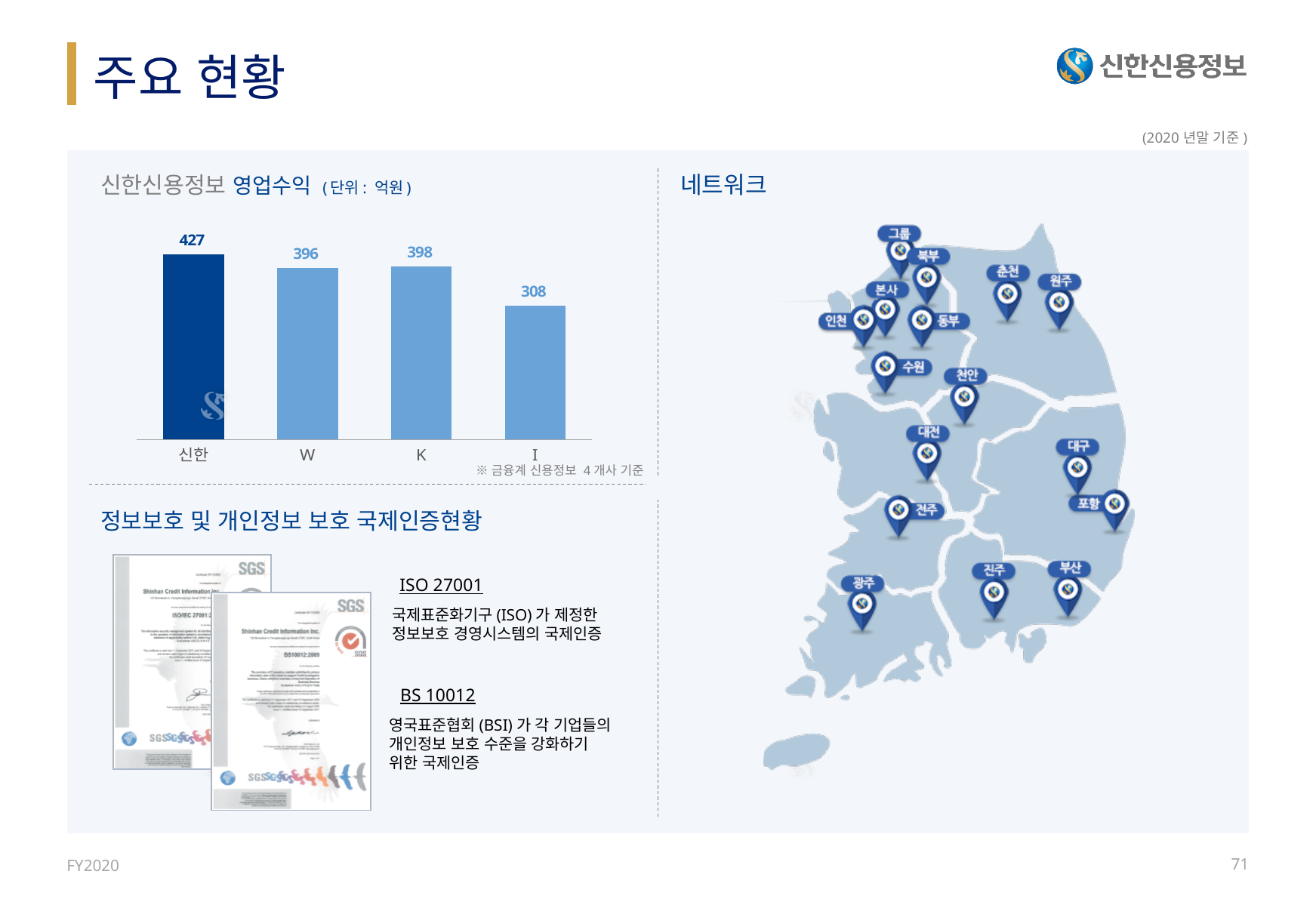
What is the 영업수익 value for 신한 in the bar chart? 427 What is the value shown for K in the 영업수익 bar chart? 398 What type of chart is used to show 신한신용정보 영업수익? bar chart What unit is stated for the 영업수익 bar chart? 억원 Which category has the lowest 영업수익 in the bar chart? I What is the value shown for I in the 영업수익 bar chart? 308 What is the value shown for W in the 영업수익 bar chart? 396 Which is larger in the 영업수익 bar chart, the value for 신한 or the value for K? 신한 What is the difference between the 영업수익 of 신한 and I? 119 How many categories are shown in the 영업수익 bar chart? 4 Which category has the highest 영업수익 in the bar chart? 신한 What is the difference between the 영업수익 of 신한 and W? 31